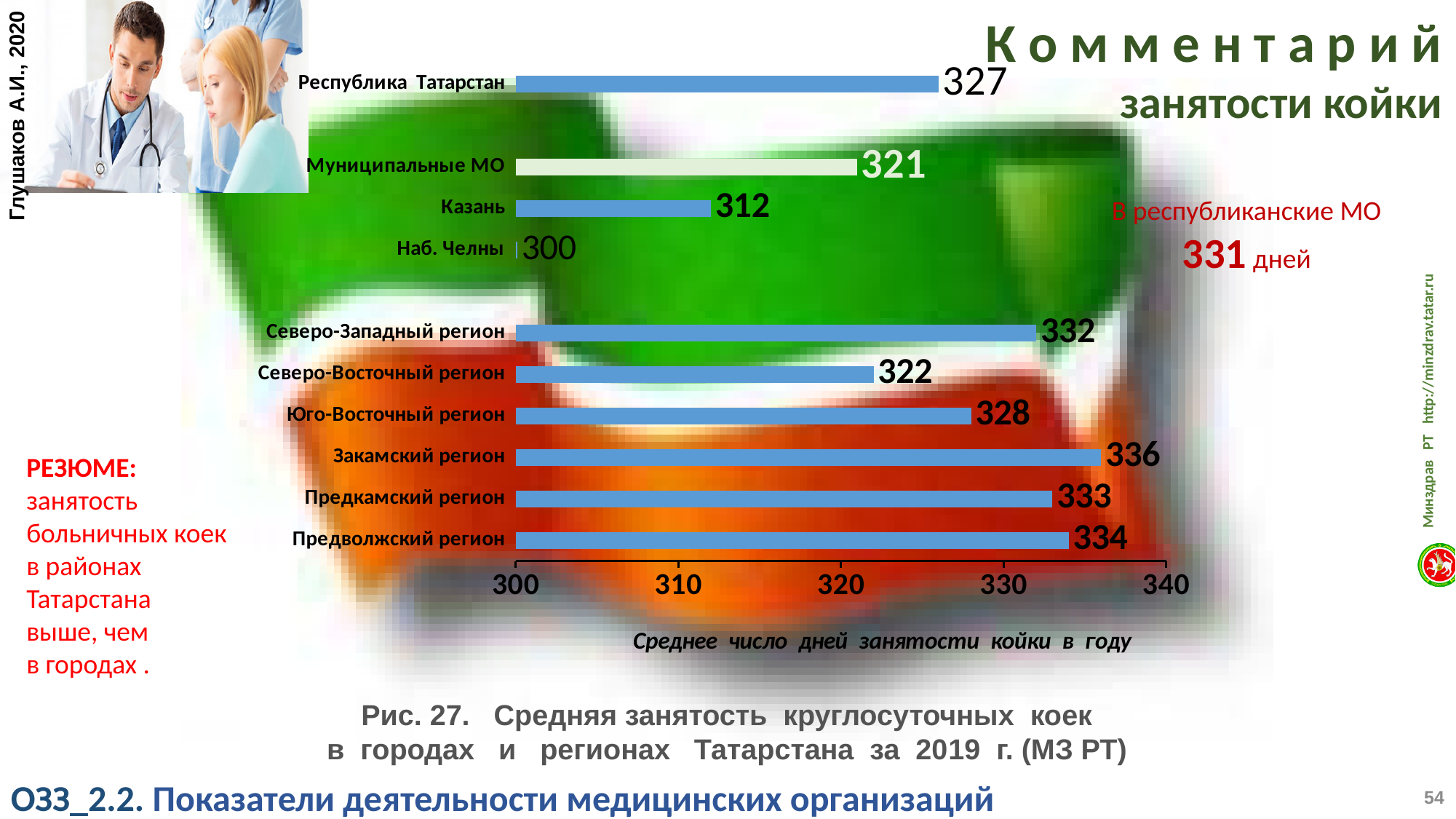
What is the x-axis label of the chart? Среднее число дней занятости койки в году Which is larger, the value for Предкамский регион or the value for Предволжский регион? Предволжский регион Which category has the highest value? Закамский регион What is the difference between the values for Закамский регион and Казань? 24 How many categories are shown in the chart? 10 What is the difference between the values for Республика Татарстан and Муниципальные МО? 6 What is the value for Республика Татарстан? 327 What kind of chart is shown on the slide? bar chart What is the value for Закамский регион? 336 What is the value for Казань? 312 What is the value for Северо-Восточный регион? 322 Which category has the lowest value? Наб. Челны